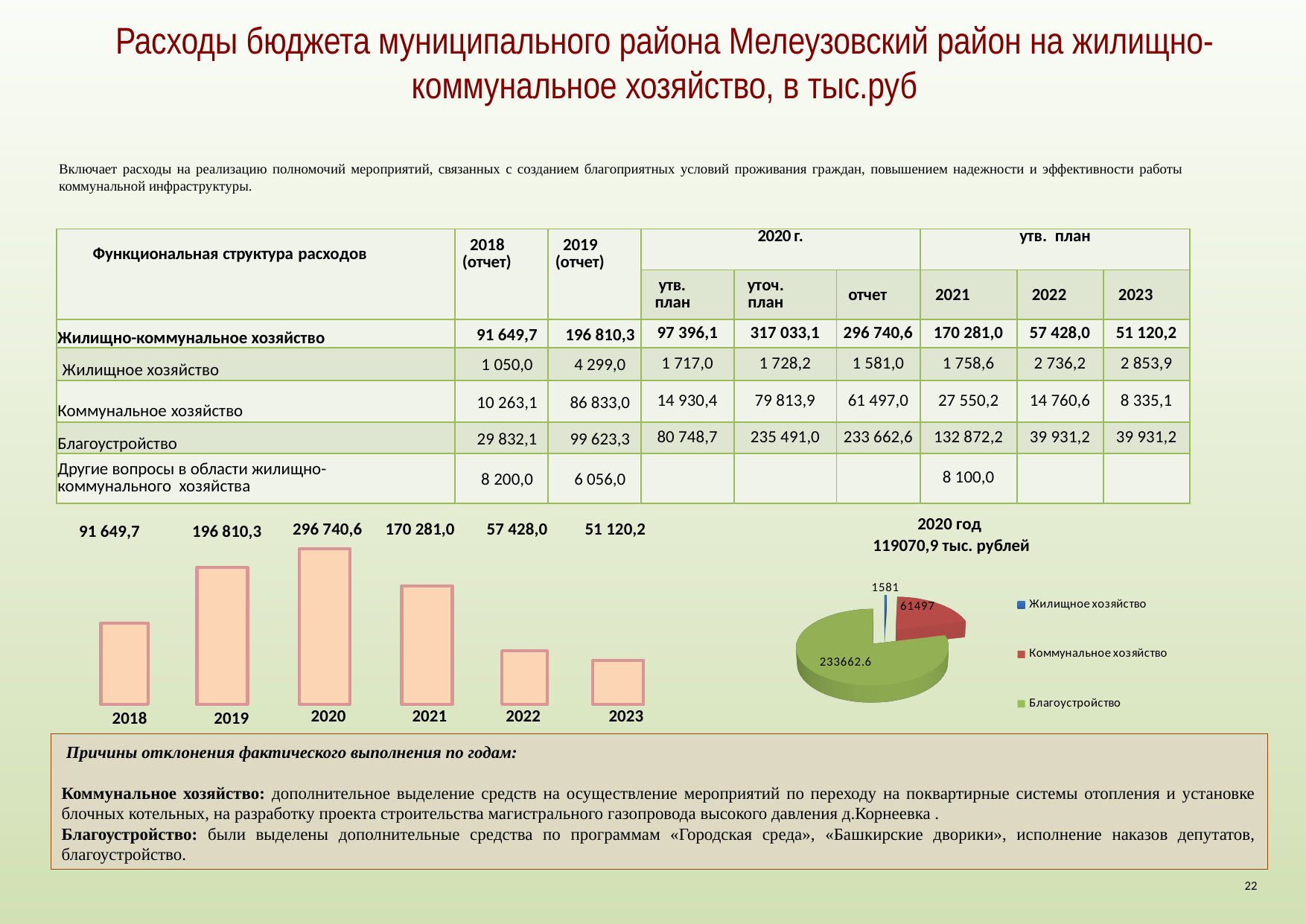
In the bar chart at the bottom left, which year has the lowest value? 2023 In the pie chart titled '2020 год', which category has the smallest slice? Жилищное хозяйство How many years are shown in the bar chart at the bottom left? 6 How many categories does the legend of the pie chart titled '2020 год' list? 3 In the pie chart titled '2020 год', what is the value for Благоустройство? 233662.6 In the bar chart at the bottom left, what is the difference between the values for 2020 and 2019? 99 930,3 What kind of chart is shown at the bottom left of the slide? bar chart In the bar chart at the bottom left, what is the value for 2023? 51 120,2 In the bar chart at the bottom left, which is larger, the value for 2019 or the value for 2021? 2019 In the bar chart at the bottom left, which year has the highest value? 2020 In the bar chart at the bottom left, do the values rise or fall from 2020 to 2023? fall In the bar chart at the bottom left, what is the value for 2020? 296 740,6